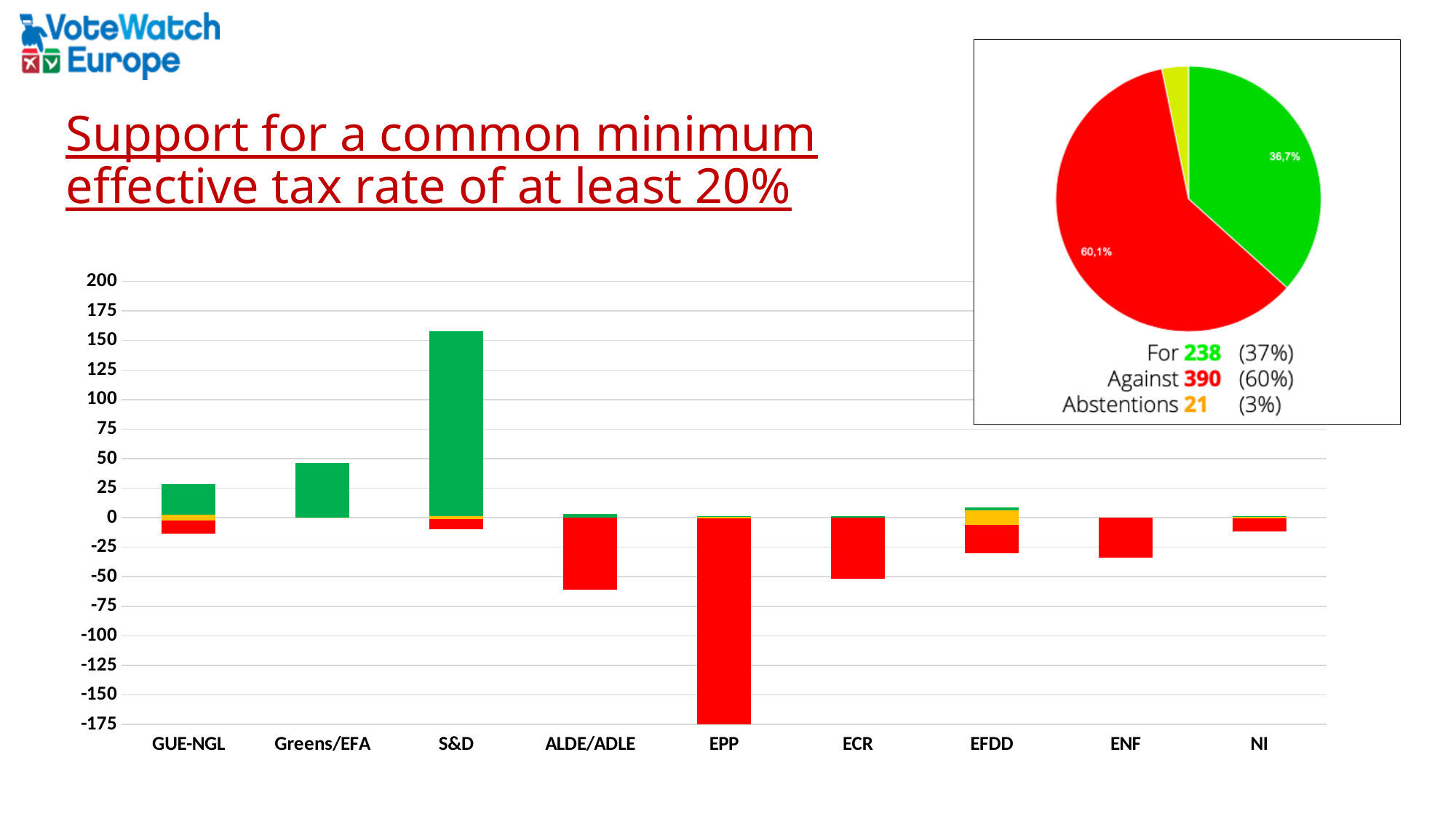
In the pie chart, how many Abstentions were there? 21 In the pie chart, how many more votes were Against than For? 152 In the bar chart, is the green (For) value for S&D greater or less than 150? greater In the pie chart, how many MEPs voted For? 238 In the pie chart, how many MEPs voted Against? 390 In the pie chart, what share of the vote was Against? 60% In the pie chart, which category has the largest slice? Against What kind of chart is the large chart at the bottom of the slide? bar chart In the bar chart, which group has the largest red (Against) bar? EPP What kind of chart is the chart in the top right of the slide? pie chart In the bar chart, how many political groups are shown on the x axis? 9 In the bar chart, which group has the tallest green (For) bar? S&D